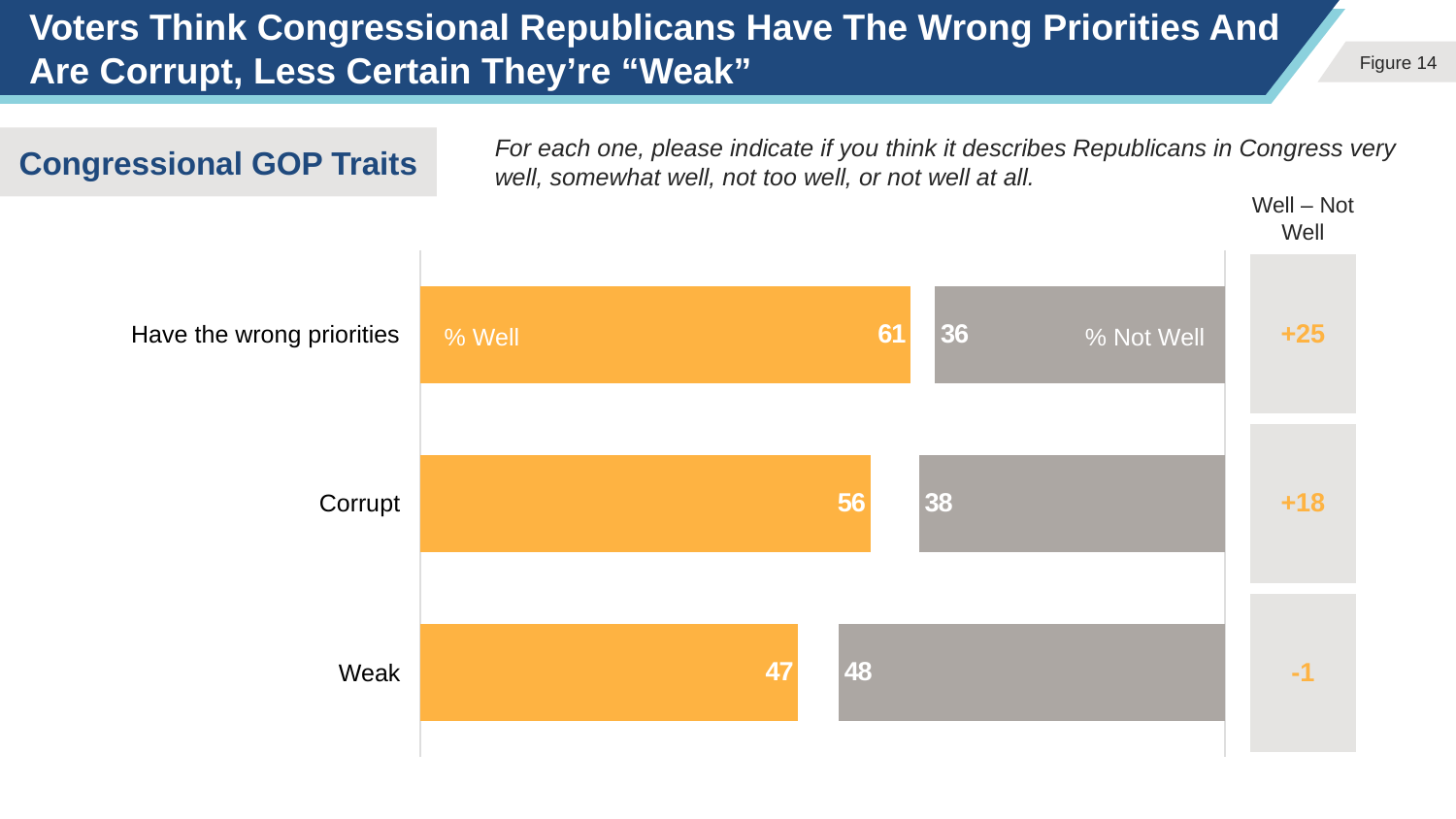
What is the % Not Well value for "Have the wrong priorities"? 36 What percentage of voters say "Have the wrong priorities" describes Republicans in Congress well? 61 Which is larger for "Weak": the % Well value or the % Not Well value? % Not Well What is the % Well value for "Weak"? 47 What colour are the % Well bars? Orange What type of chart is shown on the slide? Bar chart What is the difference between the % Well and % Not Well values for "Corrupt"? 18 What percentage of voters say "Corrupt" does not describe Republicans in Congress well? 38 How many traits are shown in the chart? 3 Which trait has the highest % Well value? Have the wrong priorities Which trait has the lowest % Well value? Weak What is the Well – Not Well value shown for "Have the wrong priorities"? +25